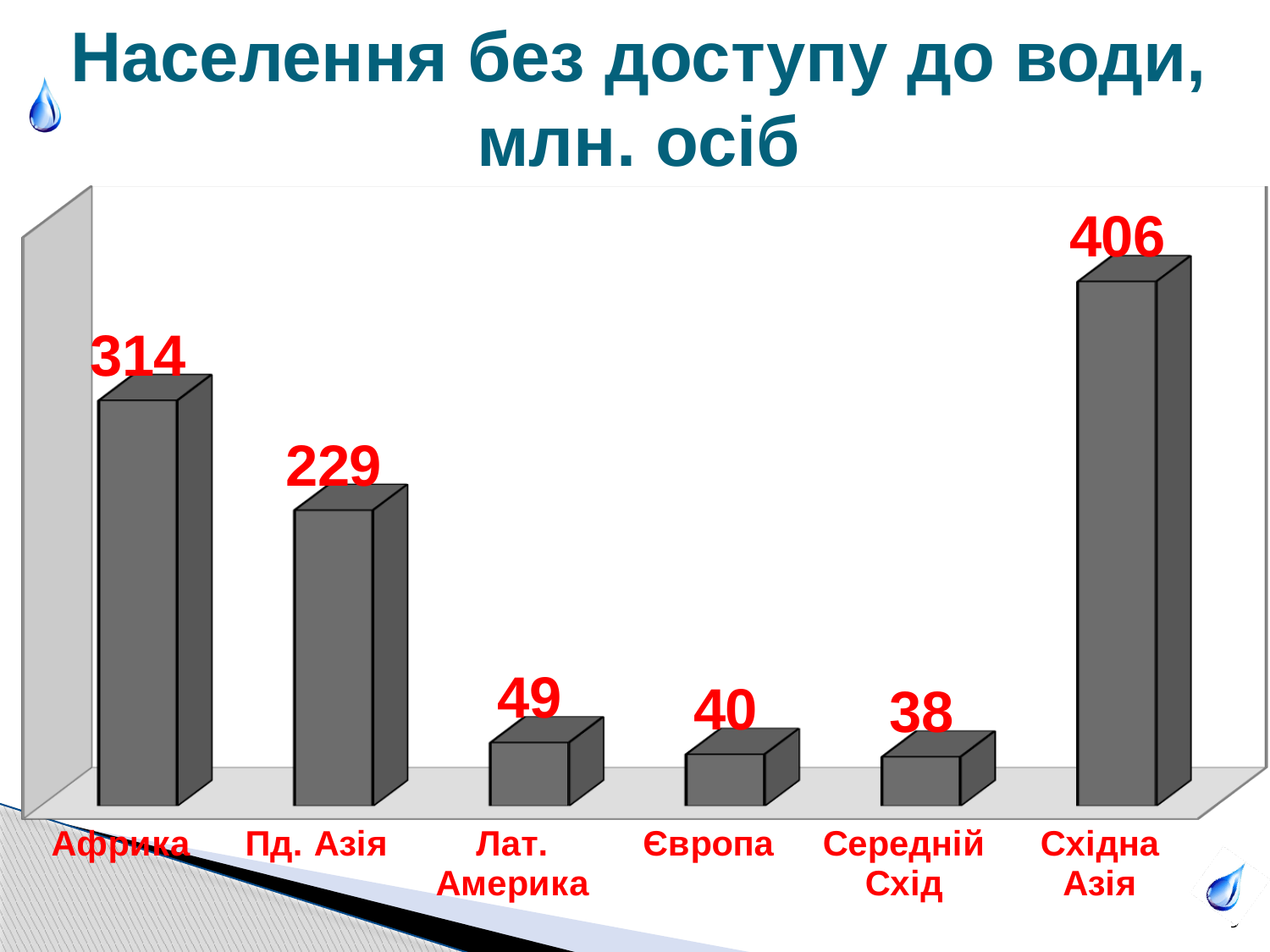
Which category has the highest value? Східна Азія Which is larger, the value for Пд. Азія or the value for Африка? Африка What is the value for Пд. Азія? 229 What is the difference between the values for Східна Азія and Африка? 92 How many categories are shown in the chart? 6 Which category has the lowest value? Середній Схід What kind of chart is shown on the slide? bar chart What is the title of the chart? Населення без доступу до води, млн. осіб What is the value for Лат. Америка? 49 What is the value for Африка? 314 What is the value for Середній Схід? 38 What is the difference between the values for Лат. Америка and Європа? 9